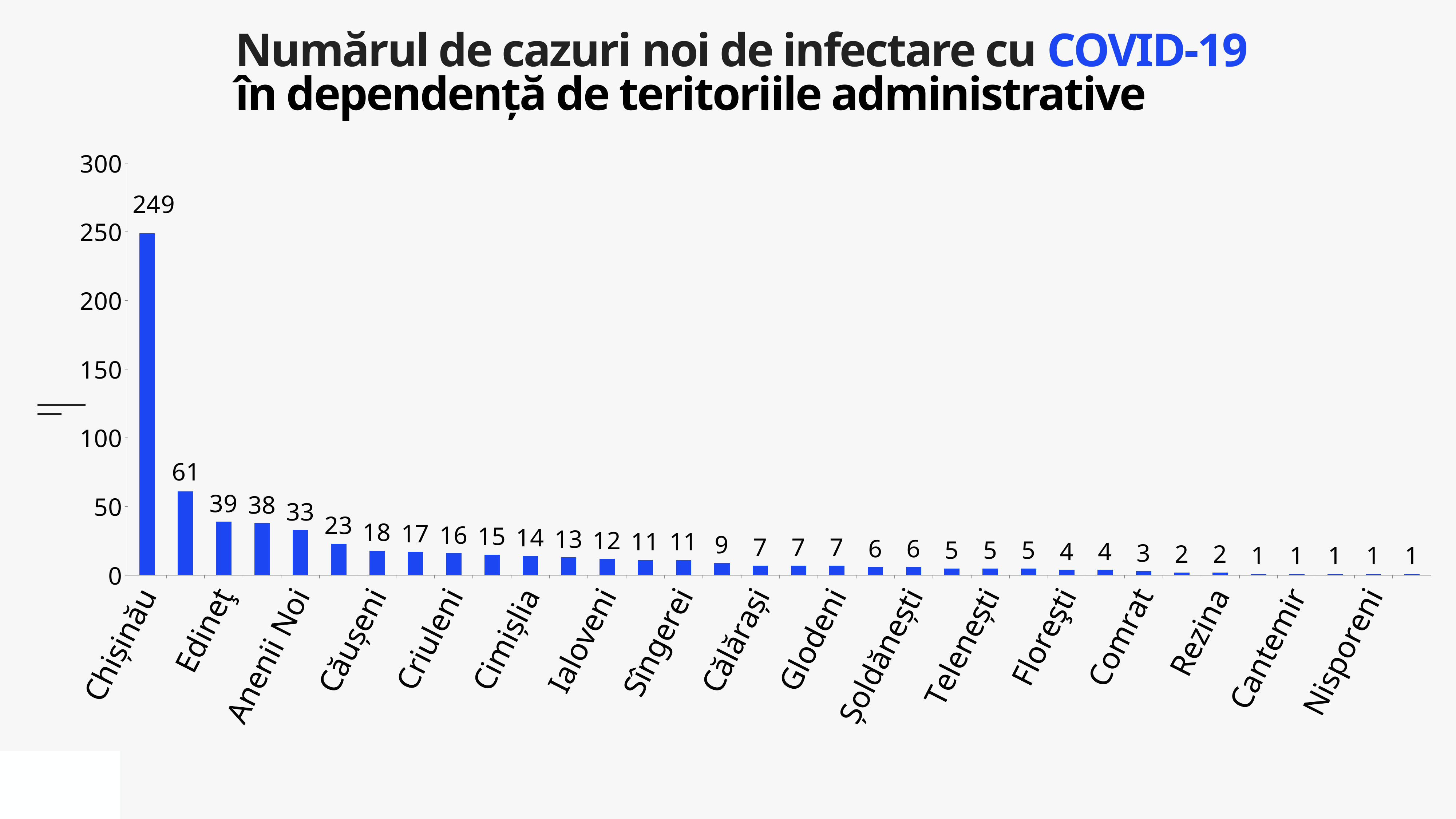
Is the value for Chișinău greater or less than 200? greater Is the value for Criuleni greater or less than 50? less What is the difference in new cases between Chișinău and Edineț? 210 Which has more new cases, Chișinău or Edineț? Chișinău Which territory has the highest number of new cases? Chișinău How many new cases are shown for Anenii Noi? 33 What type of chart is shown on the slide? bar chart How many new COVID-19 cases are shown for Chișinău? 249 How many bars are plotted in the chart? 34 Do the values rise or fall from left to right along the x axis? fall How many new cases are shown for Edineț? 39 How many new cases are shown for Căușeni? 18